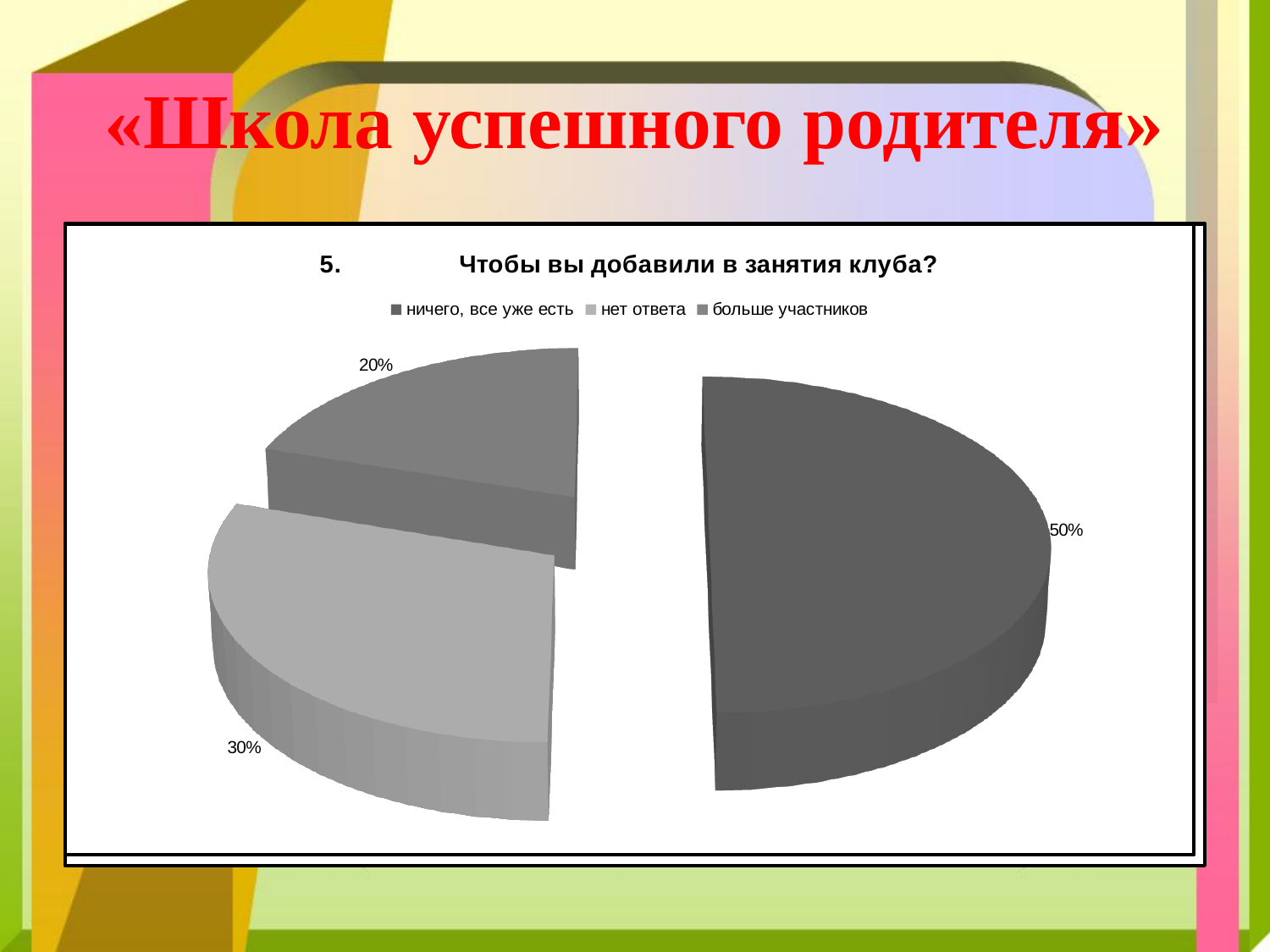
What is the title of the chart? 5. Чтобы вы добавили в занятия клуба? How many slices does the pie chart have? 3 What share of the pie is labelled for "нет ответа"? 30% Which category has the smallest slice of the pie? больше участников What is the difference between the shares for "ничего, все уже есть" and "нет ответа"? 20% What share of the pie is labelled for "больше участников"? 20% What kind of chart is shown on the slide? pie chart What is the combined share of "нет ответа" and "больше участников"? 50% Which category has the largest slice of the pie? ничего, все уже есть What share of the pie is labelled for "ничего, все уже есть"? 50% Which is larger: the share for "нет ответа" or the share for "больше участников"? нет ответа How many entries does the legend list? 3